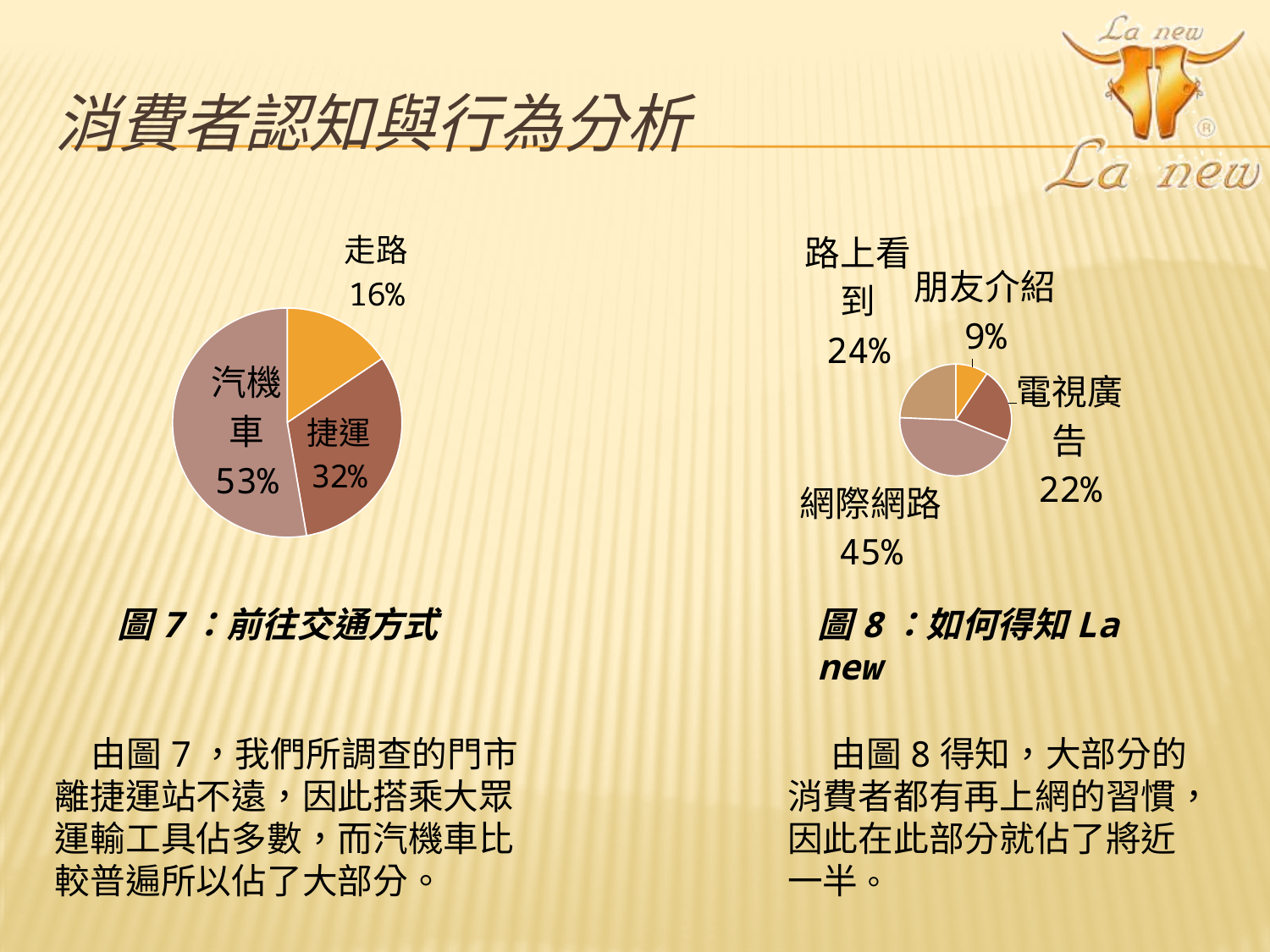
In the right chart (圖 8：如何得知 La new), which category has the smallest share? 朋友介紹 What kind of chart is the left chart (圖 7：前往交通方式)? Pie chart In the right chart (圖 8：如何得知 La new), which category has the largest share? 網際網路 In the left chart (圖 7：前往交通方式), which category has the smallest share? 走路 In the left chart (圖 7：前往交通方式), what share is 捷運? 32% In the right chart (圖 8：如何得知 La new), which is larger, 路上看到 or 朋友介紹? 路上看到 In the right chart (圖 8：如何得知 La new), how many categories are shown? 4 In the right chart (圖 8：如何得知 La new), what share is 電視廣告? 22% In the left chart (圖 7：前往交通方式), what is the difference between the shares of 汽機車 and 捷運? 21% In the left chart (圖 7：前往交通方式), how many slices does the pie have? 3 In the left chart (圖 7：前往交通方式), what share is 汽機車? 53% In the right chart (圖 8：如何得知 La new), what share is 網際網路? 45%